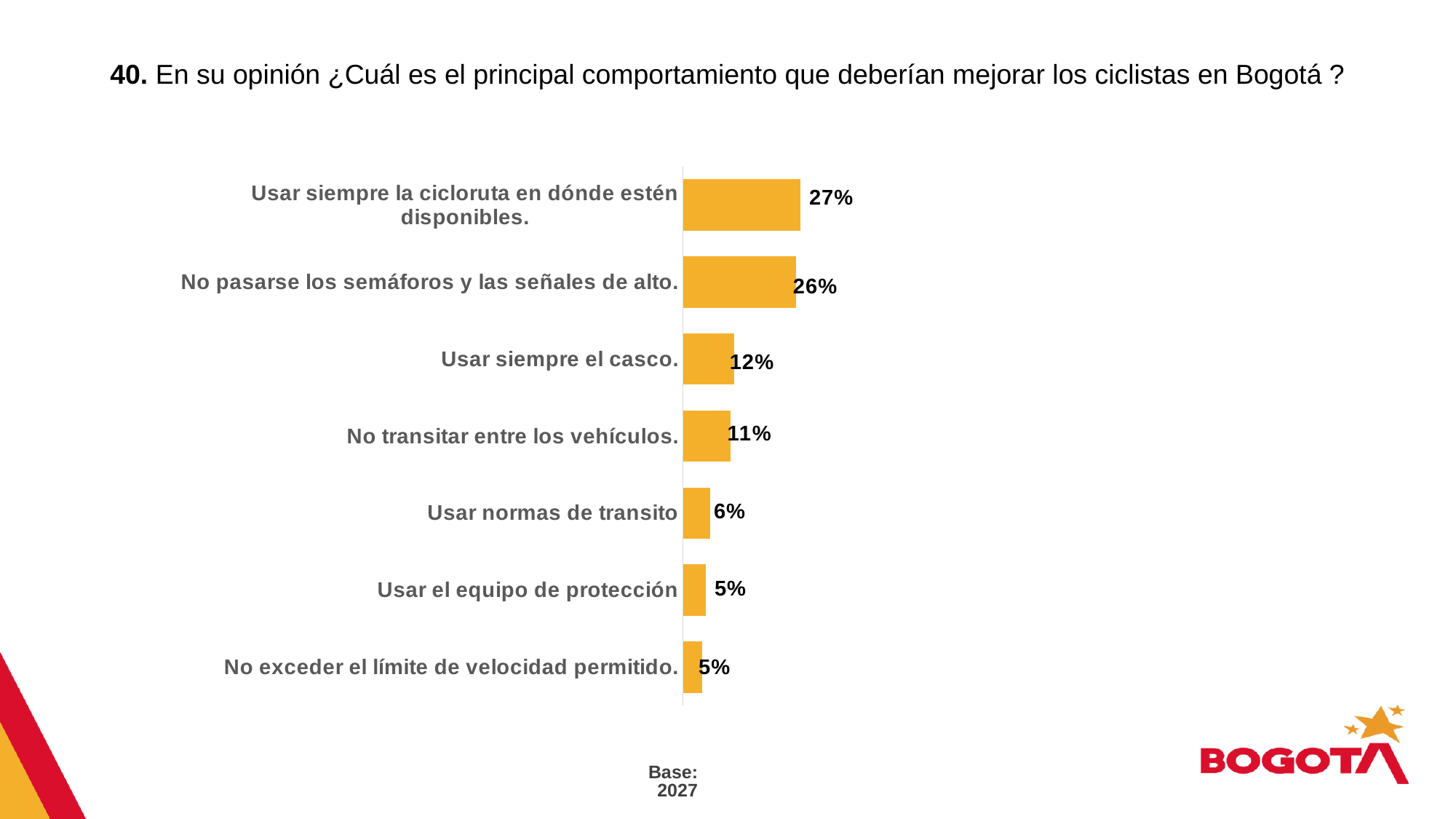
Which is larger, the value for "Usar siempre el casco." or the value for "Usar normas de transito"? Usar siempre el casco. What is the base (number of respondents) shown below the chart? 2027 What colour are the bars in the chart? Yellow/orange Which category has the highest value? Usar siempre la cicloruta en dónde estén disponibles. What is the value for "Usar siempre el casco."? 12% What is the value for "No pasarse los semáforos y las señales de alto."? 26% What is the value for "Usar normas de transito"? 6% What is the value for "Usar siempre la cicloruta en dónde estén disponibles."? 27% How many categories are shown in the chart? 7 What kind of chart is shown on the slide? Bar chart What is the difference between the values for "Usar siempre la cicloruta en dónde estén disponibles." and "Usar siempre el casco."? 15% What is the difference between the values for "No transitar entre los vehículos." and "Usar el equipo de protección"? 6%